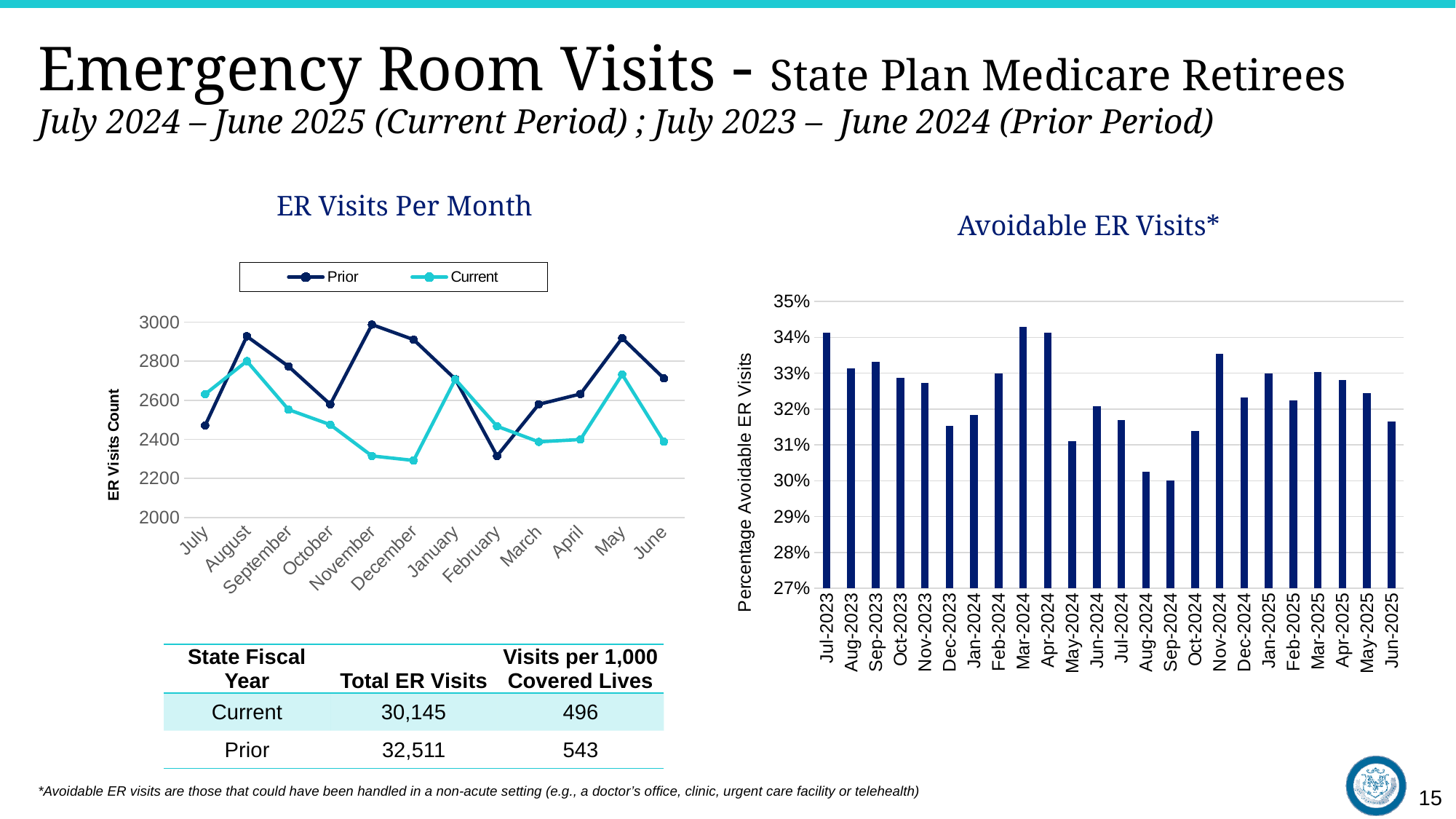
In the "Avoidable ER Visits*" chart, is the value for Sep-2024 greater or less than 31%? less In the "ER Visits Per Month" chart, which series has the larger value in August, Prior or Current? Prior In the "ER Visits Per Month" chart, which month has the highest value for the Current series? August What kind of chart is the "Avoidable ER Visits*" chart? bar chart In the "ER Visits Per Month" chart, is the Prior value for November greater or less than 2800? greater What kind of chart is the "ER Visits Per Month" chart? line chart In the "ER Visits Per Month" chart, which month has the lowest value for the Prior series? February How many months are plotted on the x axis of the "ER Visits Per Month" chart? 12 In the "ER Visits Per Month" chart, is the Current value for November greater or less than 2400? less In the "ER Visits Per Month" chart, which month has the highest value for the Prior series? November How many bars are shown in the "Avoidable ER Visits*" chart? 24 How many series does the legend of the "ER Visits Per Month" chart list? 2